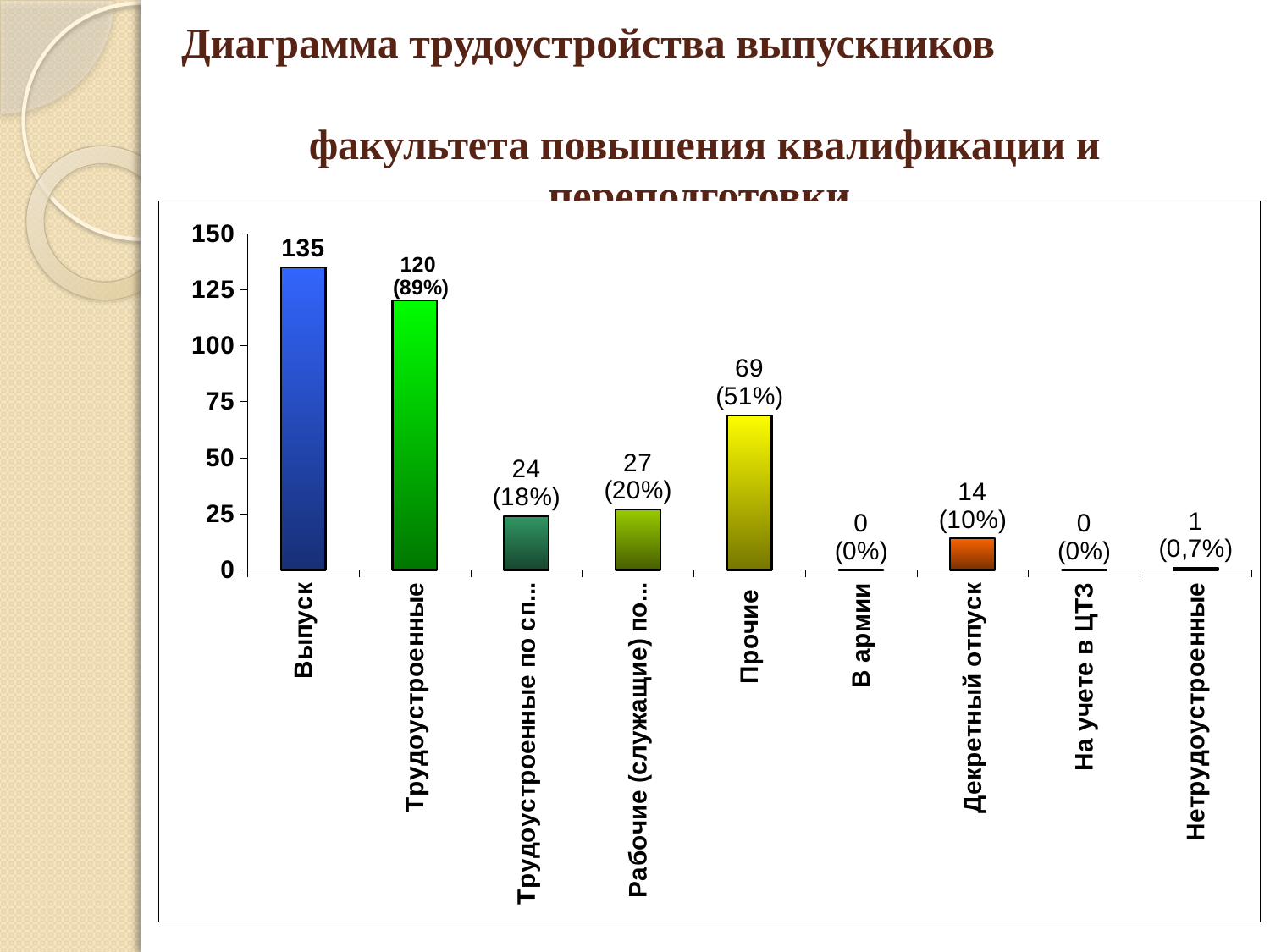
What is the value for Выпуск? 135 What percentage is shown for Нетрудоустроенные? 0,7% What is the value for Трудоустроенные? 120 What percentage is shown for Прочие? 51% What is the difference between the values for Прочие and Декретный отпуск? 55 What kind of chart is shown on the slide? bar chart What is the value for Декретный отпуск? 14 What is the difference between the values for Выпуск and Трудоустроенные? 15 How many categories have a value of 0? 2 How many categories are shown on the x axis of the chart? 9 Which is larger, the value for Прочие or the value for Декретный отпуск? Прочие Which category has the highest value? Выпуск